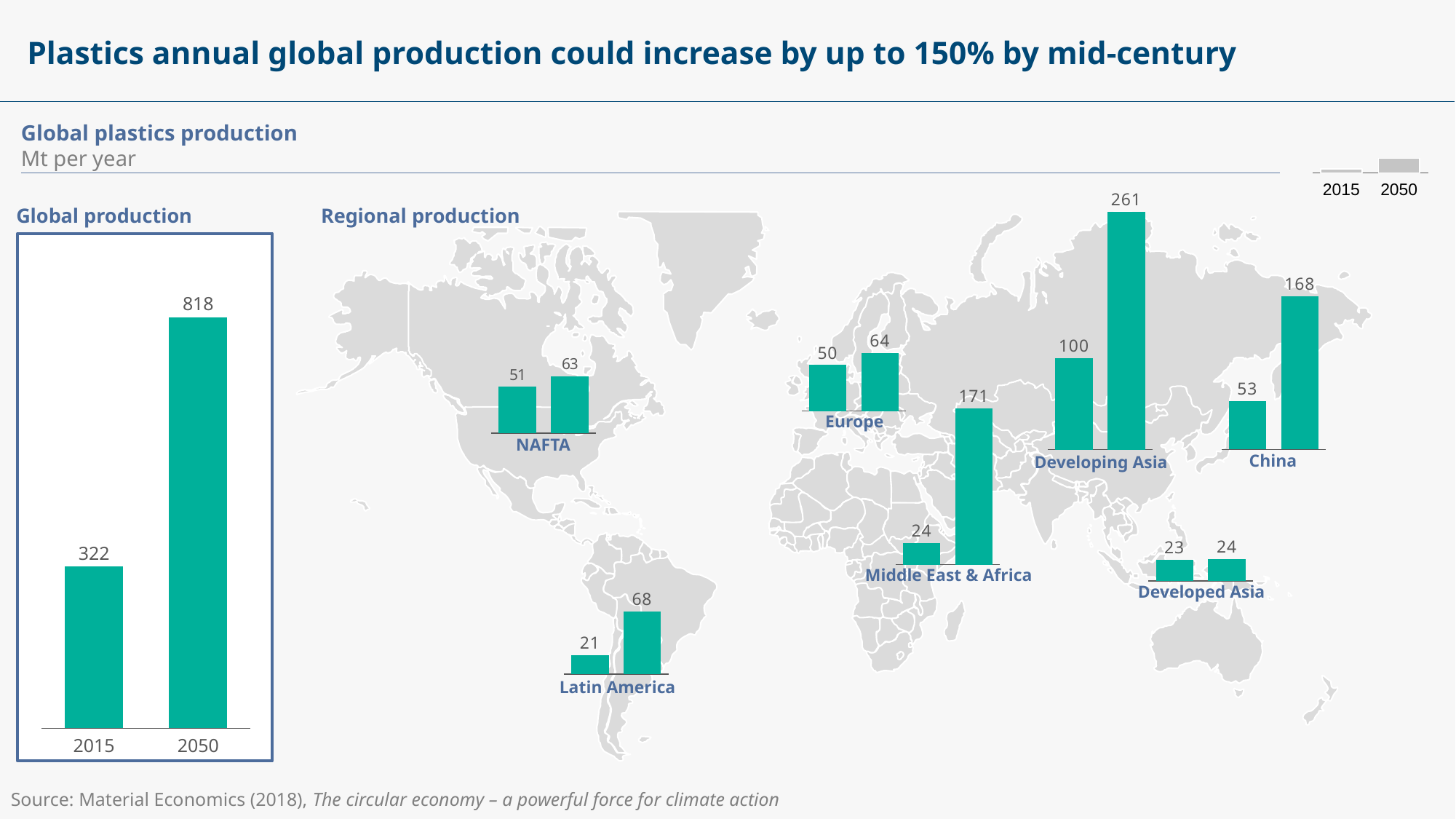
How many series does the legend list for the charts? 2 What kind of chart is the Global production chart? Bar chart In the Regional production chart, which region has the lowest 2015 value? Latin America In the Regional production chart, what is the difference between China's 2050 and 2015 values? 115 In the Regional production chart, what is the 2050 value for Developing Asia? 261 How many regions are shown in the Regional production chart? 7 In the Global production chart, what is the value for 2050? 818 In the Regional production chart, which is larger: the 2015 value for Developing Asia or the 2015 value for China? Developing Asia In the Regional production chart, what is the 2015 value for Middle East & Africa? 24 In the Regional production chart, which region has the highest 2050 value? Developing Asia In the Global production chart, what is the difference between the 2050 and 2015 values? 496 In the Global production chart, what is the value for 2015? 322